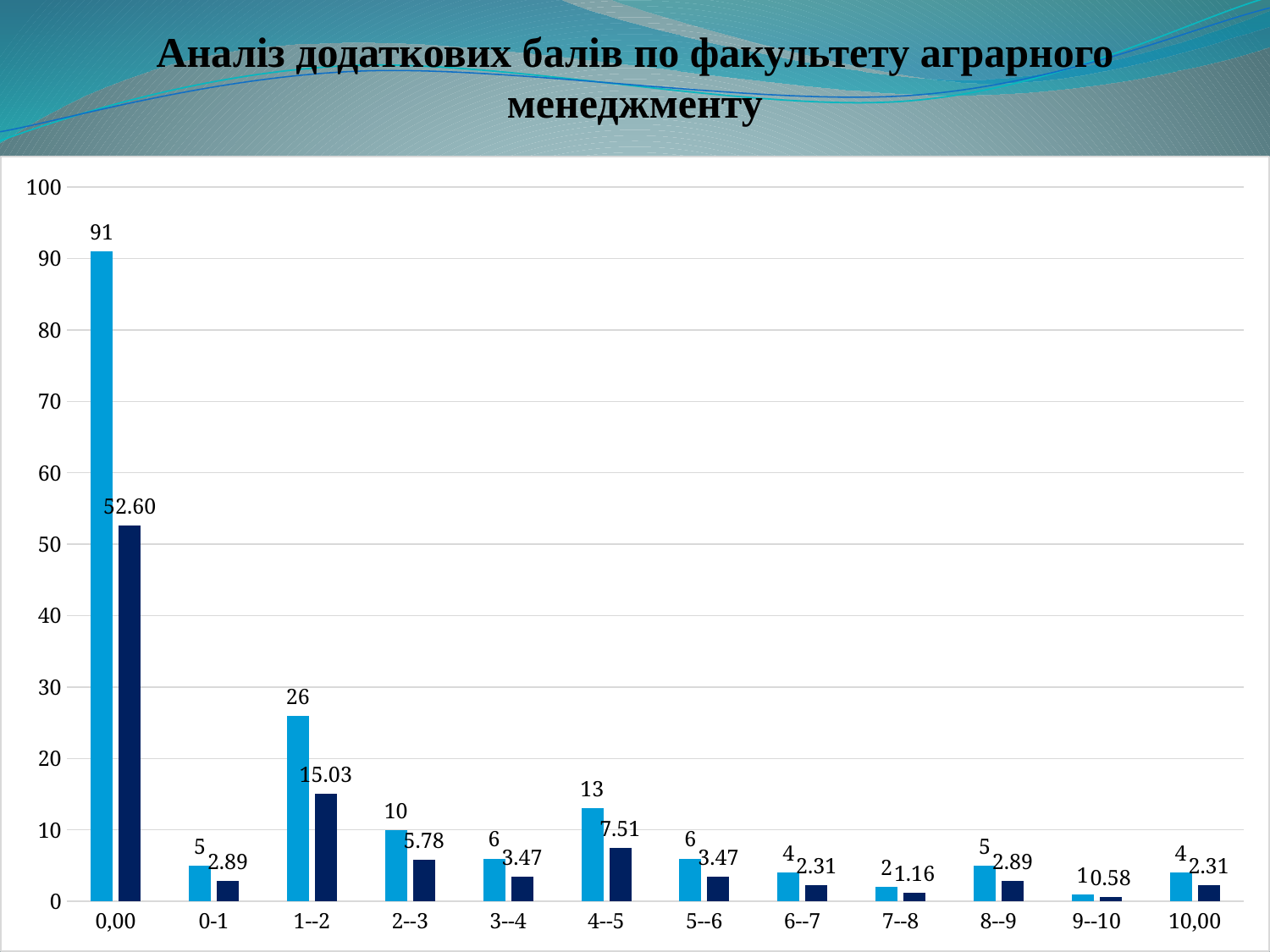
What is the value of the light blue bar for the category 1--2? 26 Which category has the lowest dark blue bar? 9--10 Is the dark blue value for 0,00 greater or less than 50? greater What is the difference between the light blue values for 0,00 and 1--2? 65 What is the value of the dark blue bar for the category 4--5? 7.51 How many categories are shown on the x axis? 12 What is the title of the slide? Аналіз додаткових балів по факультету аграрного менеджменту Which category has the highest light blue bar? 0,00 What kind of chart is shown on the slide? bar chart What is the value of the dark blue bar for the category 0,00? 52.60 Which is larger, the light blue value for 2--3 or the light blue value for 4--5? 4--5 What is the value of the light blue bar for the category 0,00? 91